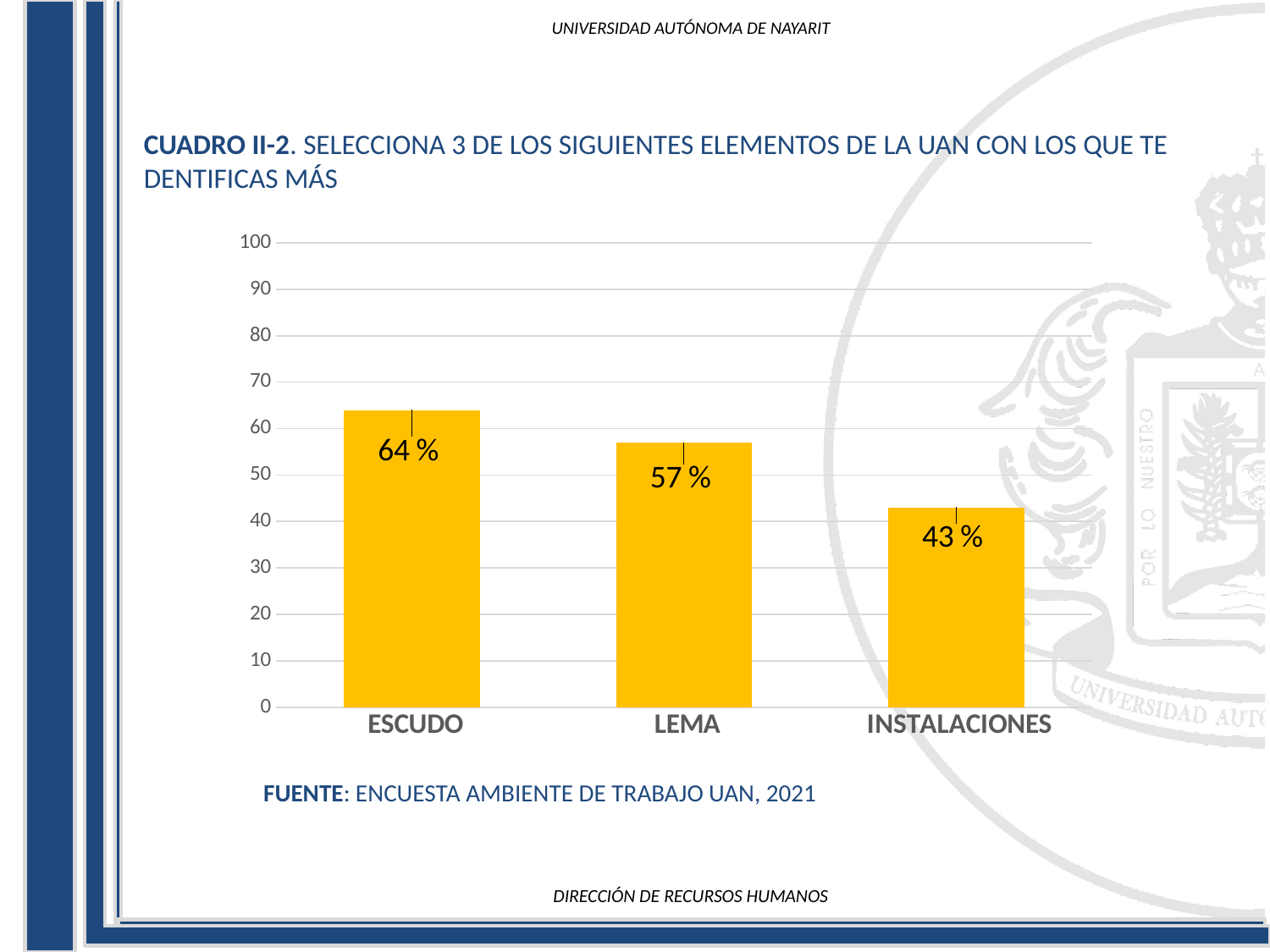
What is the difference between the values for ESCUDO and LEMA? 7 % What is the value for INSTALACIONES? 43 % How many categories are shown in the chart? 3 What is the value for ESCUDO? 64 % What is the value for LEMA? 57 % What kind of chart is shown on the slide? bar chart Which category has the lowest value? INSTALACIONES What source is cited below the chart? ENCUESTA AMBIENTE DE TRABAJO UAN, 2021 Is the value for LEMA greater or less than 50? greater Which category has the highest value? ESCUDO What is the difference between the values for ESCUDO and INSTALACIONES? 21 % Which is larger, the value for LEMA or the value for INSTALACIONES? LEMA